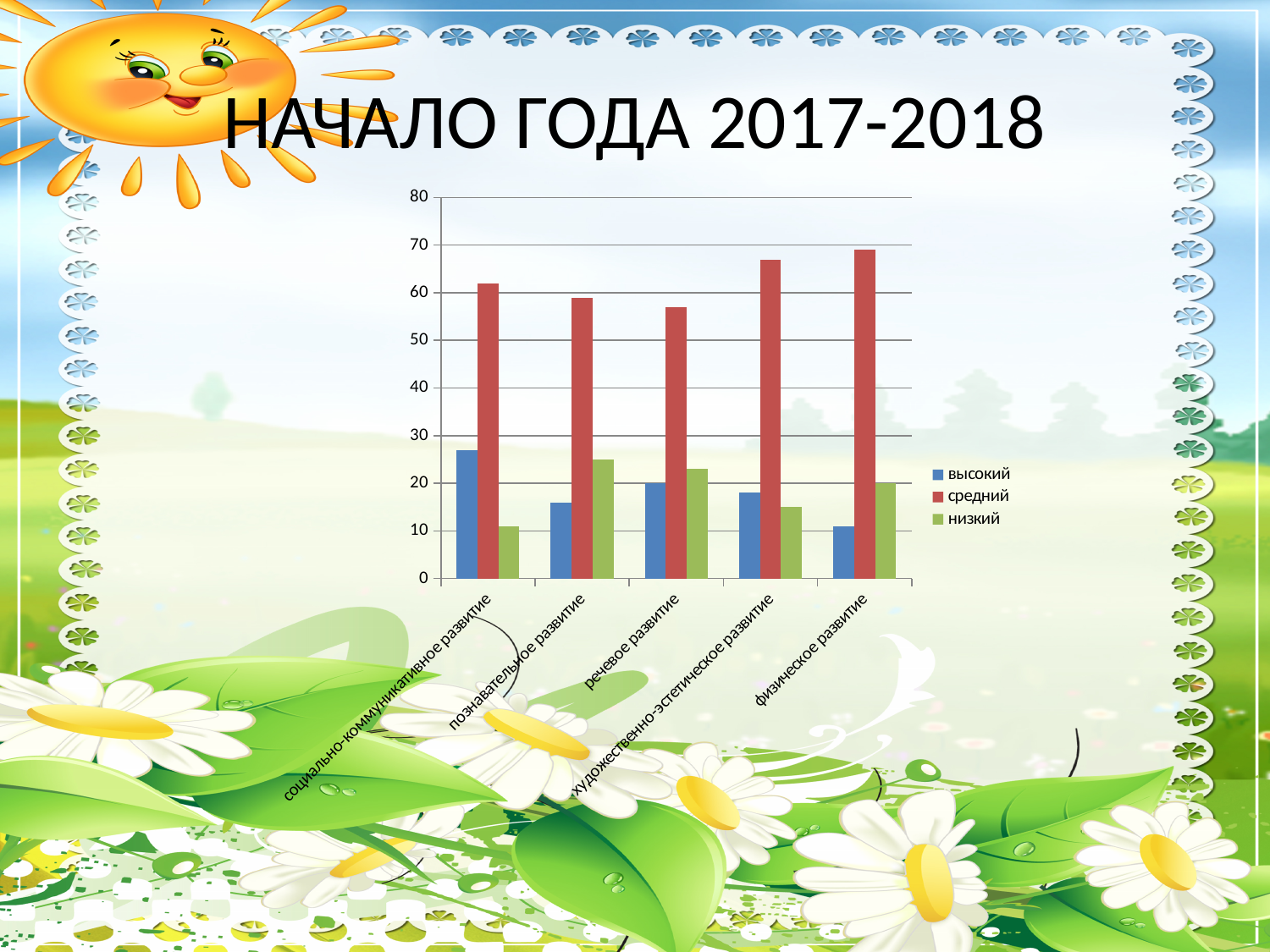
For познавательное развитие, which is larger: the высокий value or the низкий value? низкий What kind of chart is shown on the slide? bar chart For социально-коммуникативное развитие, which is larger: the высокий value or the низкий value? высокий Is the низкий value for художественно-эстетическое развитие greater or less than 20? less How many series does the legend list? 3 Is the высокий value for социально-коммуникативное развитие greater or less than 30? less Which category has the lowest value for the низкий series? социально-коммуникативное развитие Which series is shown in red in the legend? средний Which category has the lowest value for the высокий series? физическое развитие How many categories are shown on the x axis? 5 Which category has the highest value for the высокий series? социально-коммуникативное развитие Is the средний value for физическое развитие greater or less than 60? greater